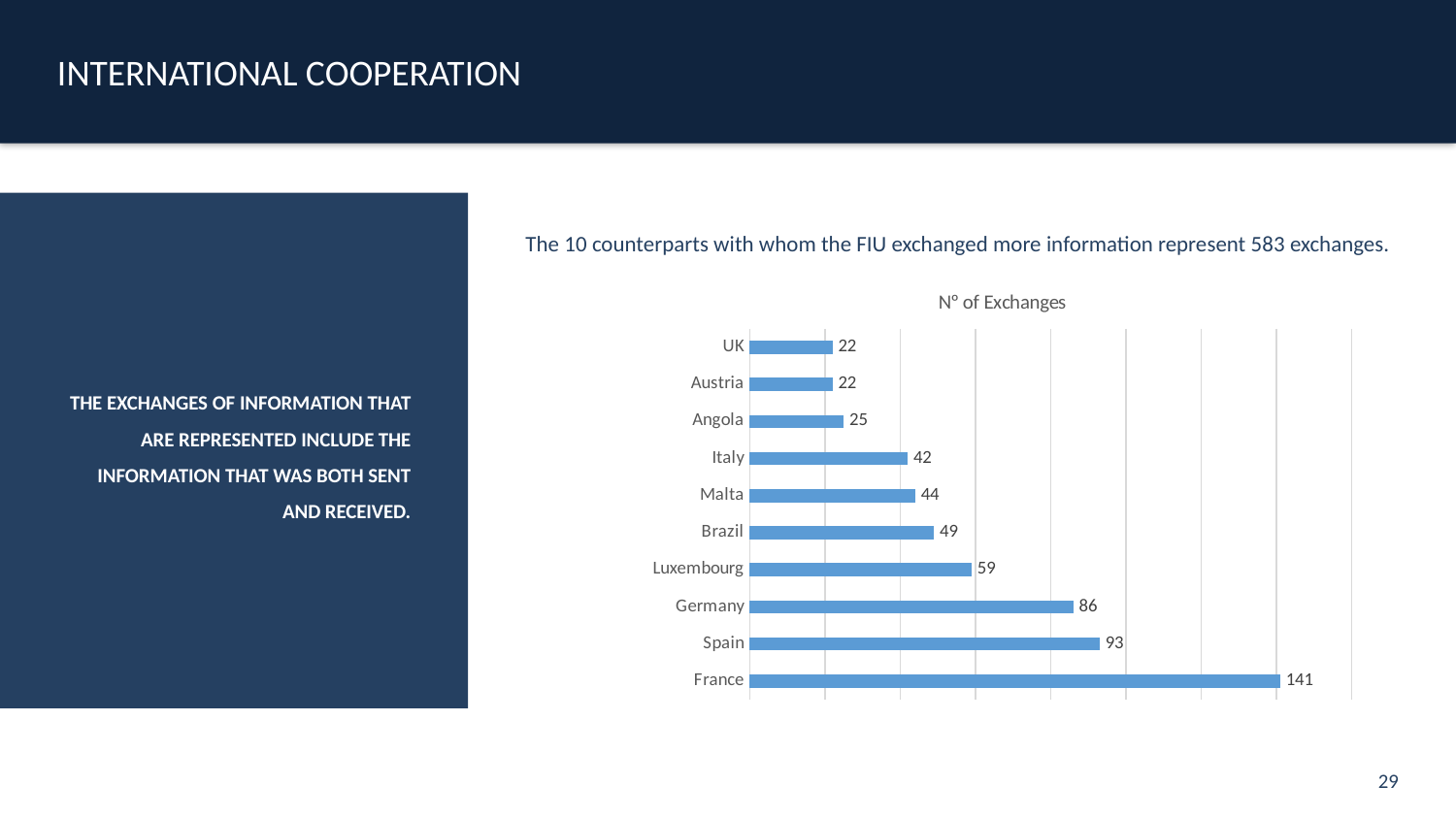
What is the difference in exchanges between France and Spain? 48 What is the title of the chart? N° of Exchanges What is the number of exchanges for Angola? 25 What type of chart is shown on the slide? Bar chart What is the difference in exchanges between Germany and Brazil? 37 How many countries are shown in the chart? 10 Which has more exchanges, Germany or Luxembourg? Germany What is the number of exchanges for Luxembourg? 59 Which country has the highest number of exchanges? France What is the number of exchanges for Malta? 44 Which has more exchanges, Malta or Italy? Malta What is the number of exchanges for France? 141